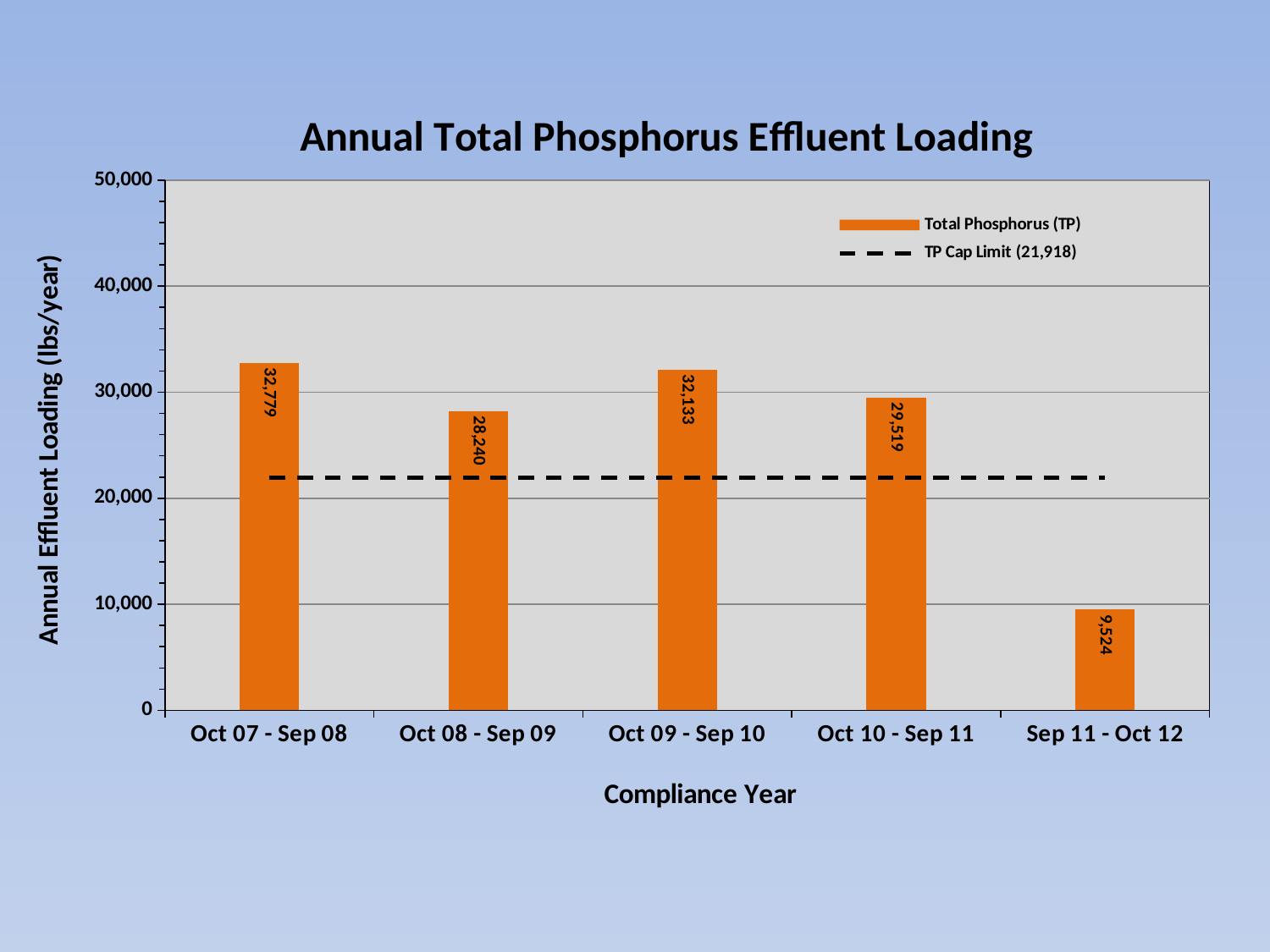
Which is larger, the Total Phosphorus value for Oct 09 - Sep 10 or for Oct 10 - Sep 11? Oct 09 - Sep 10 How many compliance years are shown on the x axis? 5 What is the Total Phosphorus value for Oct 07 - Sep 08? 32,779 Which compliance year has the highest Total Phosphorus loading? Oct 07 - Sep 08 How many entries does the legend list? 2 What is the TP Cap Limit shown in the legend? 21,918 What is the difference between the Total Phosphorus values for Oct 07 - Sep 08 and Oct 08 - Sep 09? 4,539 What is the Total Phosphorus value for Oct 10 - Sep 11? 29,519 What kind of chart is this? bar chart Which compliance year has the lowest Total Phosphorus loading? Sep 11 - Oct 12 What is the Total Phosphorus value for Sep 11 - Oct 12? 9,524 Is the Total Phosphorus value for Sep 11 - Oct 12 greater or less than 10,000? less